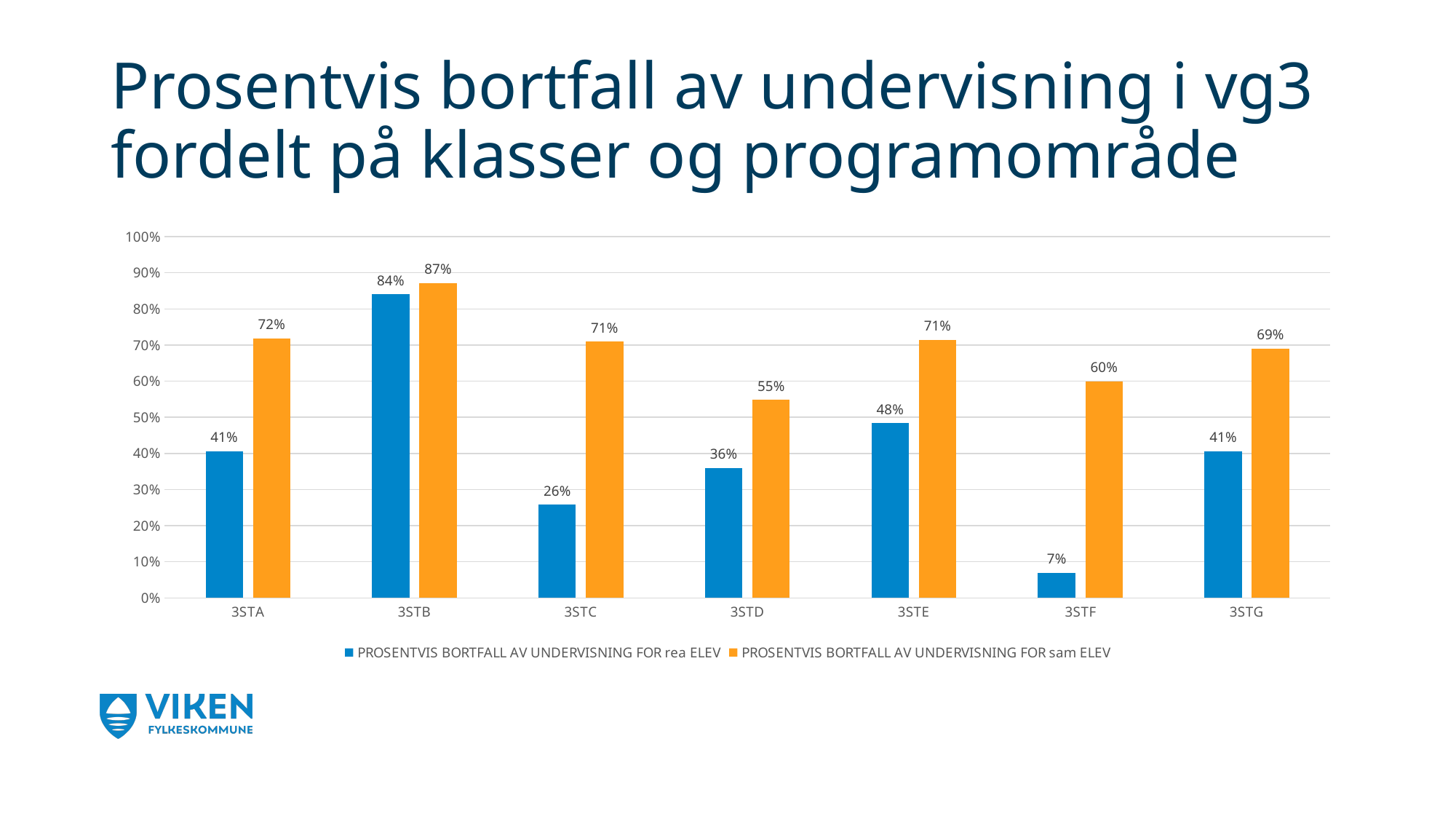
Is the rea ELEV value for 3STD greater or less than 40%? less What colour are the bars for the 'PROSENTVIS BORTFALL AV UNDERVISNING FOR sam ELEV' series? orange Which class has the highest value in the 'PROSENTVIS BORTFALL AV UNDERVISNING FOR sam ELEV' series? 3STB What is the difference between the sam ELEV value and the rea ELEV value for 3STF? 53% What is the value for 3STF in the 'PROSENTVIS BORTFALL AV UNDERVISNING FOR sam ELEV' series? 60% What is the difference between the sam ELEV values for 3STB and 3STD? 32% What kind of chart is shown on the slide? bar chart Which class has the lowest value in the 'PROSENTVIS BORTFALL AV UNDERVISNING FOR rea ELEV' series? 3STF How many series does the legend list? 2 For 3STC, which series has the larger value: rea ELEV or sam ELEV? sam ELEV What is the value for 3STB in the 'PROSENTVIS BORTFALL AV UNDERVISNING FOR rea ELEV' series? 84% How many classes are shown on the x axis? 7